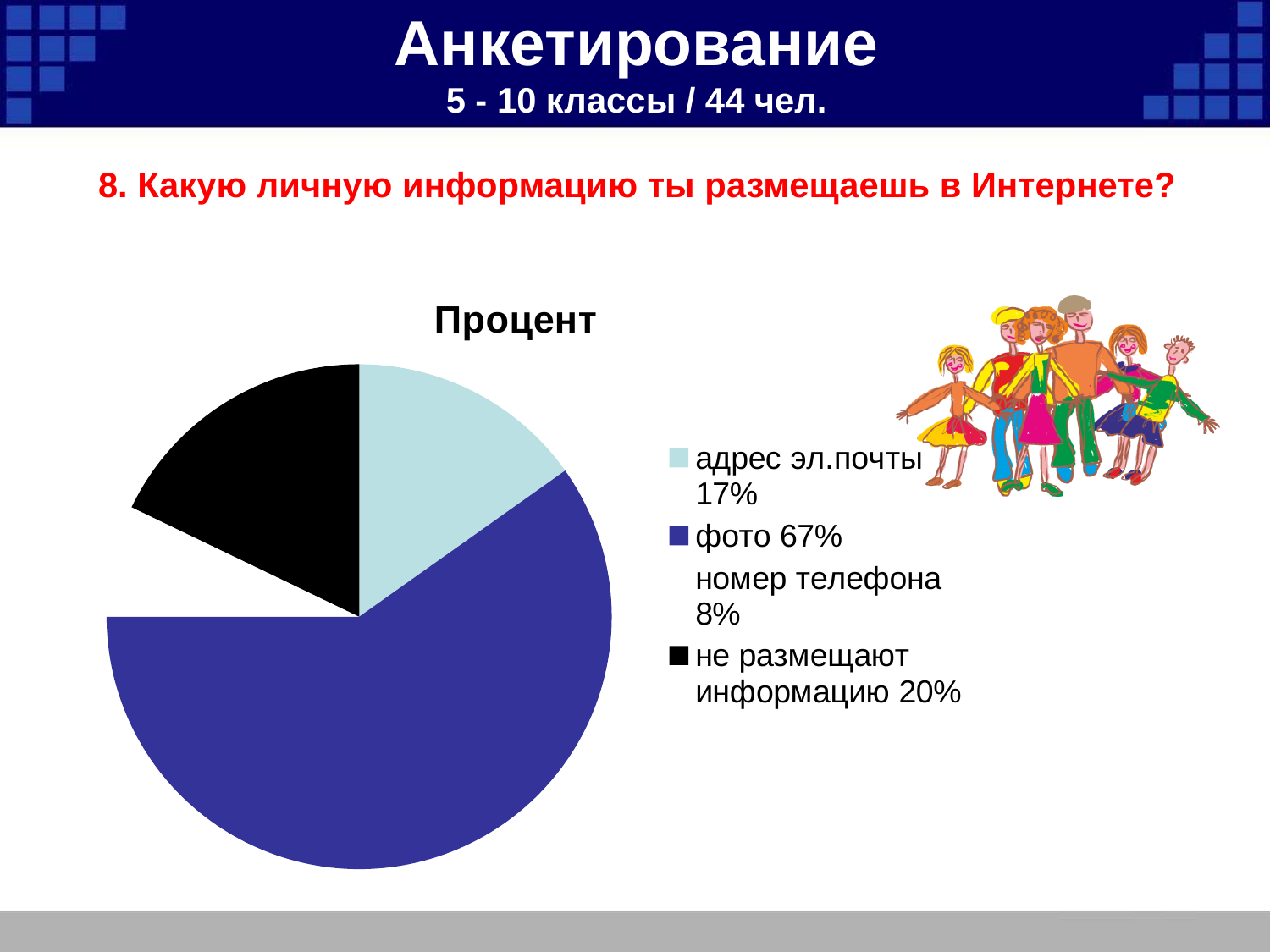
What is the difference between the percentages for "фото" and "не размещают информацию"? 47% Which category has the smallest share according to the legend? номер телефона What percentage is shown for "фото"? 67% What is the title of the chart? Процент What percentage is shown for "адрес эл.почты"? 17% How many categories are listed in the chart legend? 4 What kind of chart is shown on the slide? pie chart What percentage is shown for "номер телефона"? 8% Which category has the largest share of the pie? фото What percentage is shown for "не размещают информацию"? 20% Which is larger: the share for "адрес эл.почты" or for "не размещают информацию"? не размещают информацию What colour is the slice for "фото"? dark blue